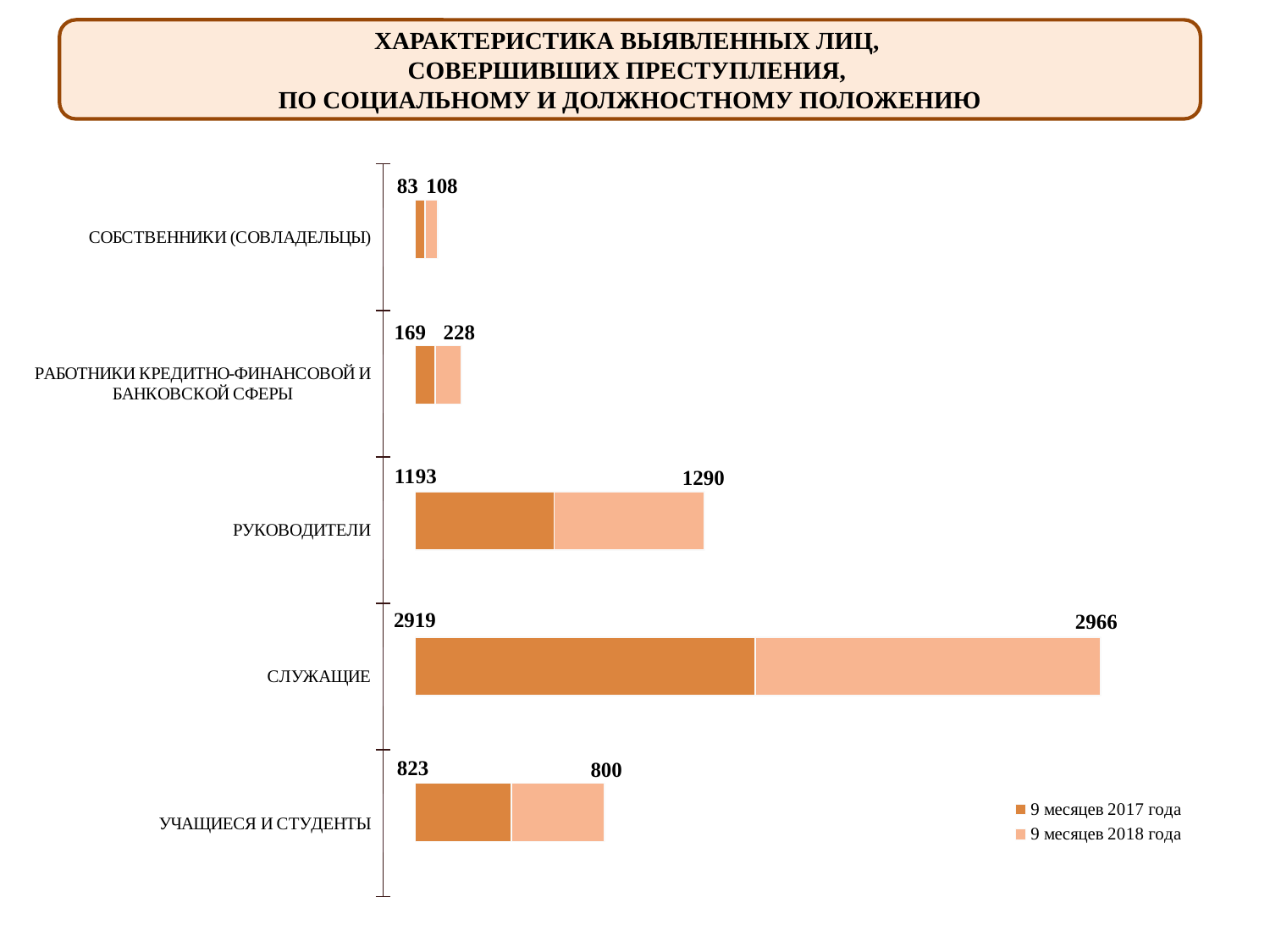
What is the value for РУКОВОДИТЕЛИ in the series 9 месяцев 2018 года? 1290 What is the value for СОБСТВЕННИКИ (СОВЛАДЕЛЬЦЫ) in the series 9 месяцев 2018 года? 108 What is the difference between the 9 месяцев 2018 года and 9 месяцев 2017 года values for РАБОТНИКИ КРЕДИТНО-ФИНАНСОВОЙ И БАНКОВСКОЙ СФЕРЫ? 59 What kind of chart is shown on the slide? Stacked bar chart Which category has the lowest value in the series 9 месяцев 2017 года? СОБСТВЕННИКИ (СОВЛАДЕЛЬЦЫ) What is the value for УЧАЩИЕСЯ И СТУДЕНТЫ in the series 9 месяцев 2017 года? 823 What is the value for СЛУЖАЩИЕ in the series 9 месяцев 2017 года? 2919 For УЧАЩИЕСЯ И СТУДЕНТЫ, which series has the larger value: 9 месяцев 2017 года or 9 месяцев 2018 года? 9 месяцев 2017 года How many categories are shown on the chart? 5 What is the total of the stacked bar for РУКОВОДИТЕЛИ? 2483 How many series does the legend list? 2 Which category has the highest value in the series 9 месяцев 2018 года? СЛУЖАЩИЕ